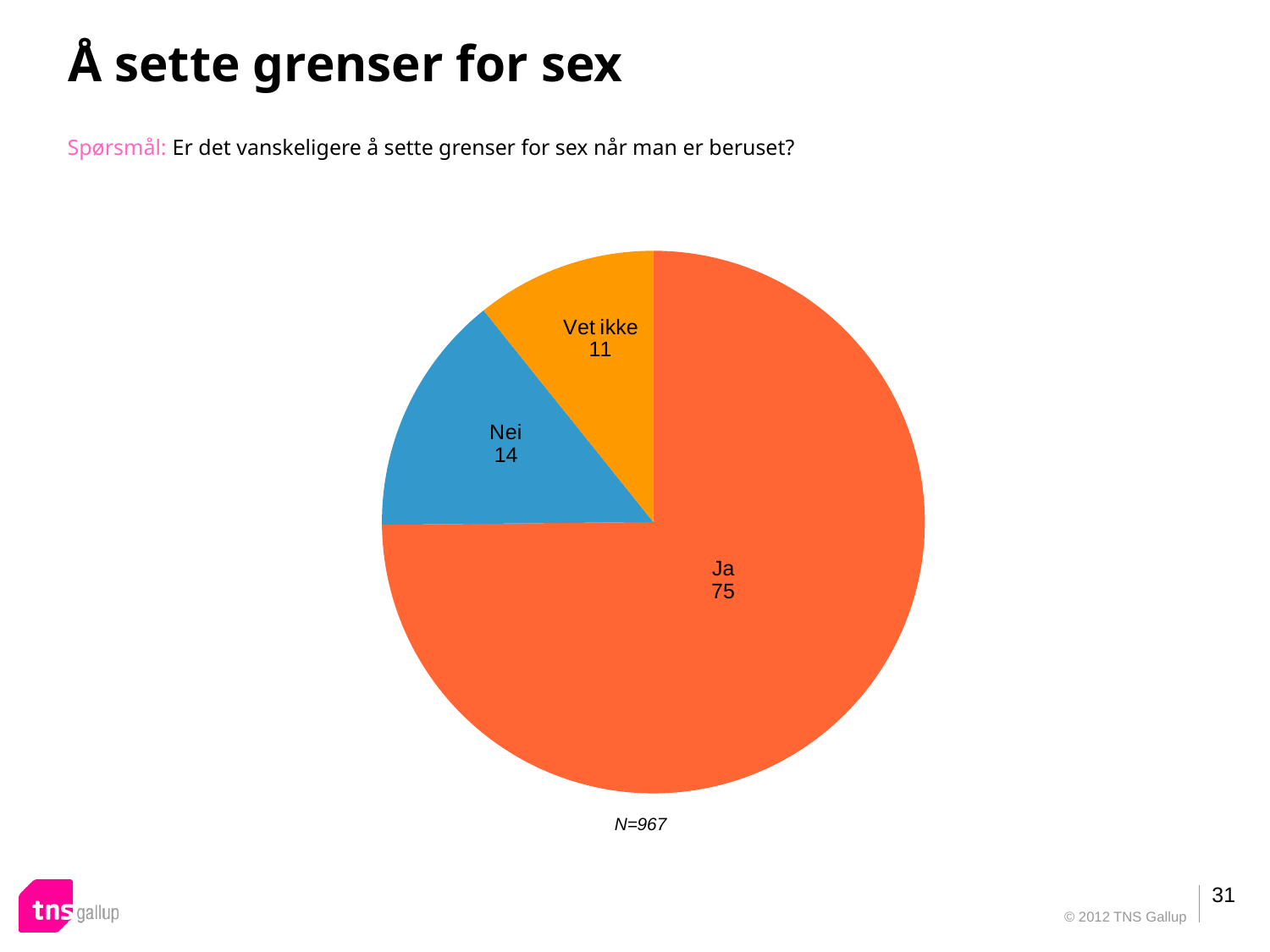
Which is larger, the value for "Nei" or the value for "Vet ikke"? Nei What is the sample size (N) stated below the pie chart? N=967 Which slice of the pie chart has the lowest value? Vet ikke What is the difference between the values for "Ja" and "Nei"? 61 What is the difference between the values for "Nei" and "Vet ikke"? 3 Which slice of the pie chart has the highest value? Ja What value is shown for the "Ja" slice of the pie chart? 75 What value is shown for the "Vet ikke" slice of the pie chart? 11 How many slices does the pie chart have? 3 What kind of chart is shown on the slide? Pie chart What colour is the "Nei" slice of the pie chart? Blue What value is shown for the "Nei" slice of the pie chart? 14